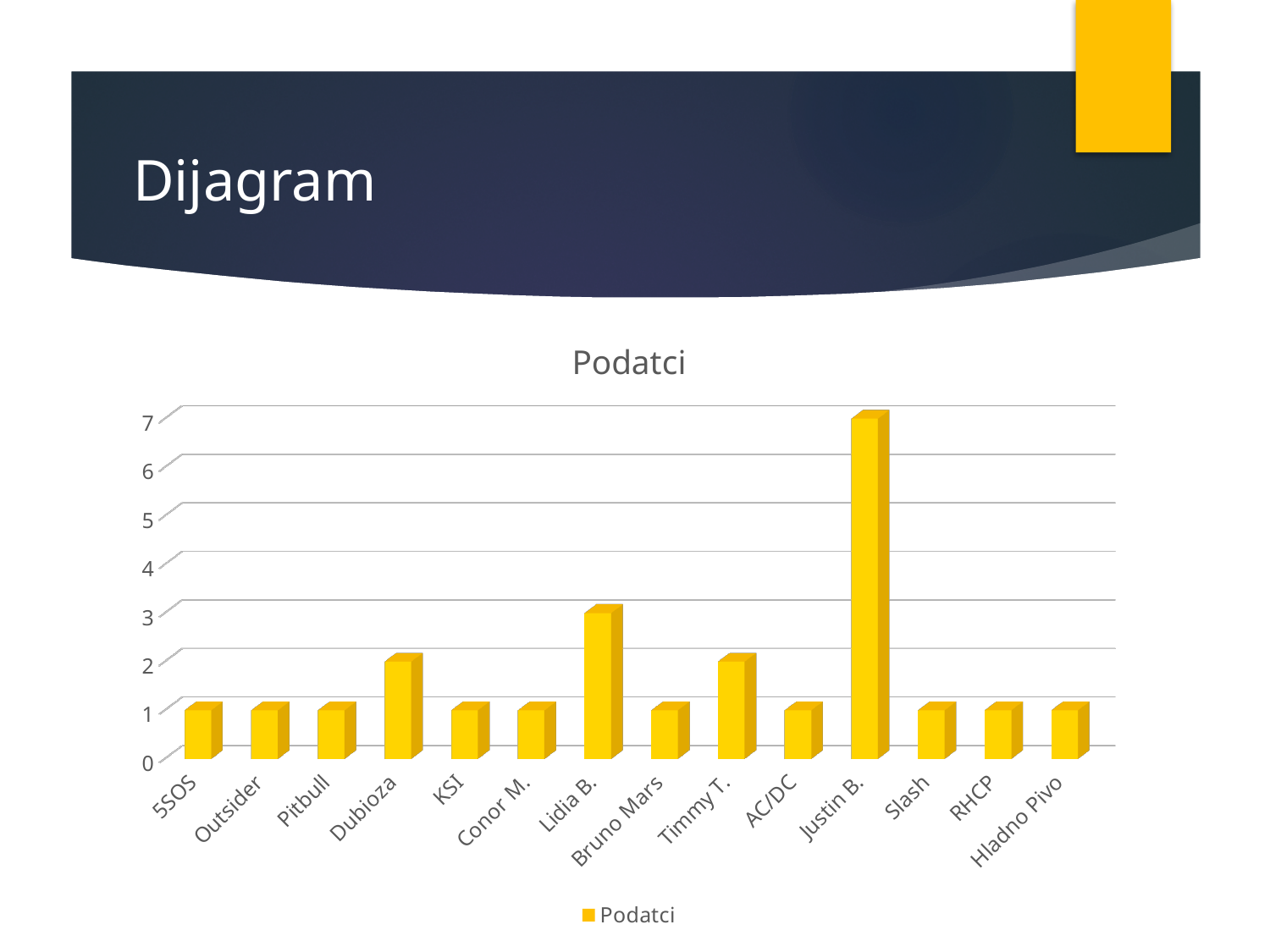
Which is larger, the value for Lidia B. or the value for Dubioza? Lidia B. What is the value for Lidia B.? 3 Is the value for Justin B. greater or less than 5? greater Which category has the highest value? Justin B. What is the value for Dubioza? 2 What is the value for Justin B.? 7 How many categories are shown on the x axis? 14 What is the value for Timmy T.? 2 What kind of chart is shown on the slide? bar chart How many series does the legend list? 1 What is the difference between the values for Justin B. and Lidia B.? 4 What is the title of the chart? Podatci